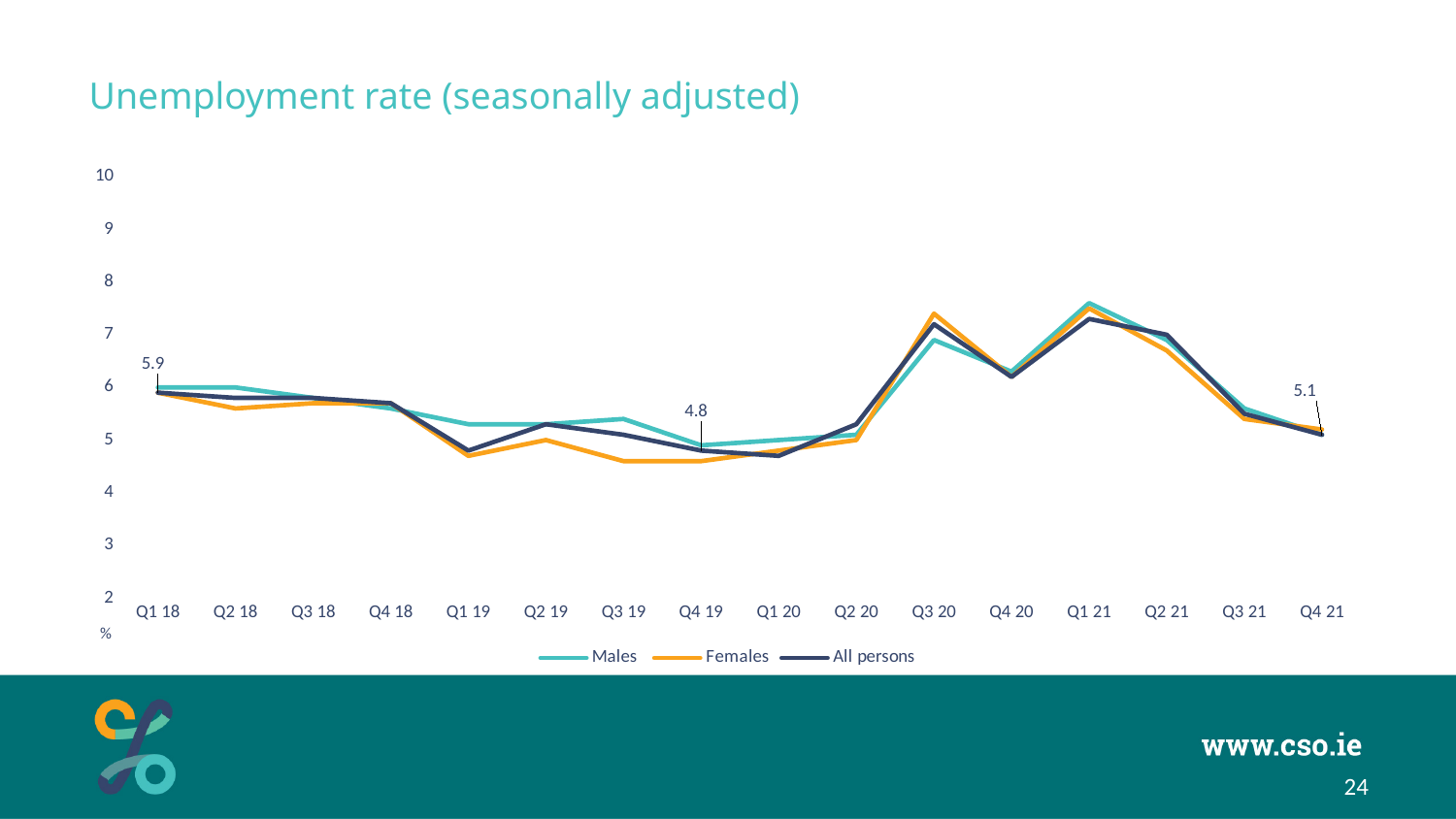
What are the three series named in the legend? Males, Females, All persons In which quarter is the Males unemployment rate highest? Q1 21 How many series does the legend list? 3 In Q3 20, which is higher, the Males rate or the Females rate? Females By how much did the All persons unemployment rate fall between Q1 18 and Q4 21? 0.8 What kind of chart is shown on the slide? line chart Is the value for Females in Q3 20 greater or less than 7? greater Is the value for Females in Q3 19 greater or less than 5? less What is the unemployment rate for All persons in Q4 21? 5.1 How many quarters are plotted along the x axis? 16 What is the unemployment rate for All persons in Q1 18? 5.9 What is the unemployment rate for All persons in Q4 19? 4.8